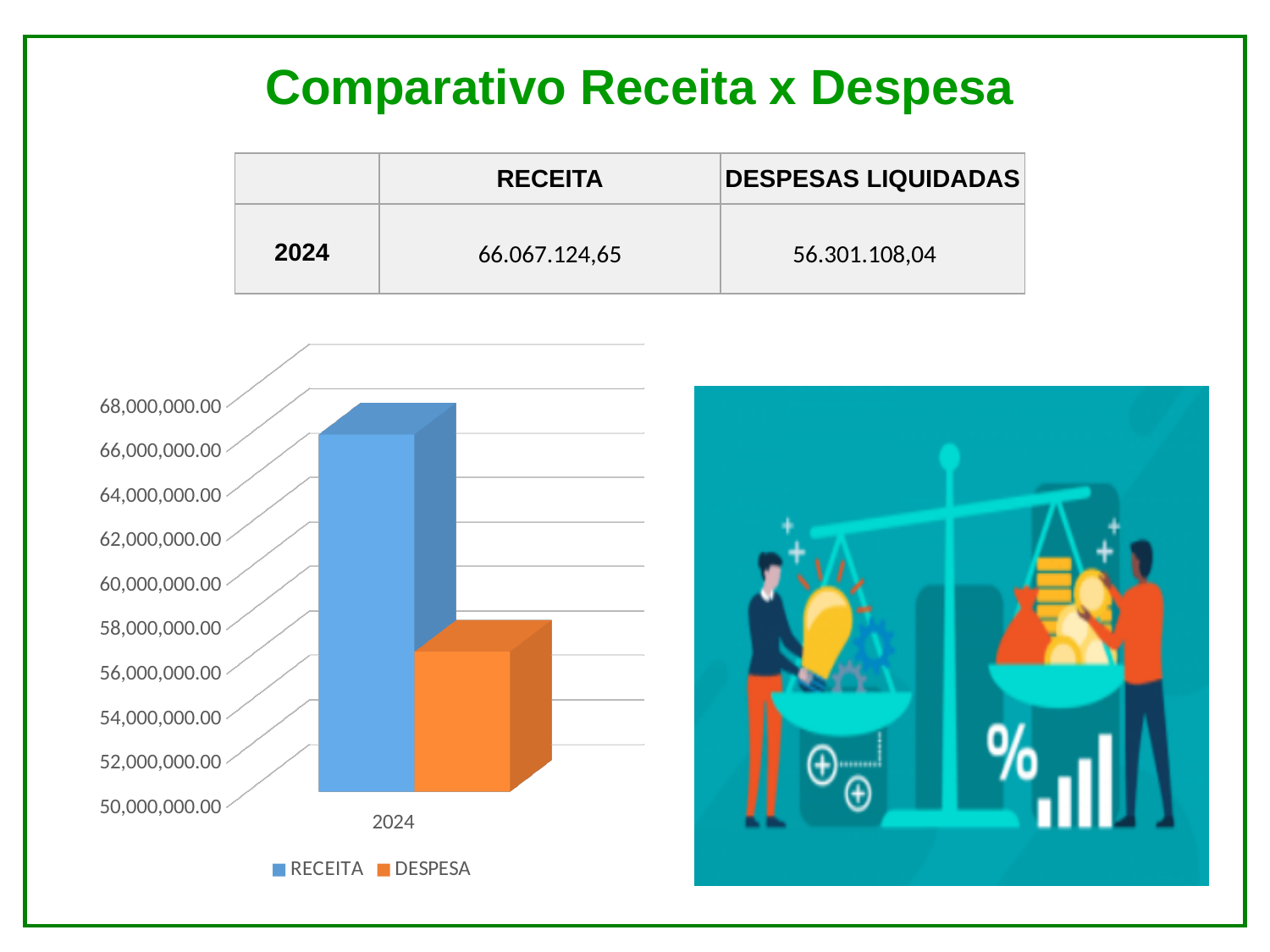
What colour is the RECEITA series in the chart? blue According to the table on the slide, what is the RECEITA value for 2024? 66.067.124,65 According to the table on the slide, what is the DESPESAS LIQUIDADAS value for 2024? 56.301.108,04 What is the title of the slide containing the chart? Comparativo Receita x Despesa Which series has the taller bar for 2024, RECEITA or DESPESA? RECEITA Which series has the lowest bar in the chart? DESPESA Is the value for RECEITA in 2024 greater or less than 64,000,000.00? greater What kind of chart is shown on the slide? bar chart How many series does the chart legend list? 2 Using the values in the table, what is the difference between RECEITA and DESPESAS LIQUIDADAS for 2024? 9.766.016,61 Is the value for DESPESA in 2024 greater or less than 60,000,000.00? less How many categories are shown on the x axis of the chart? 1